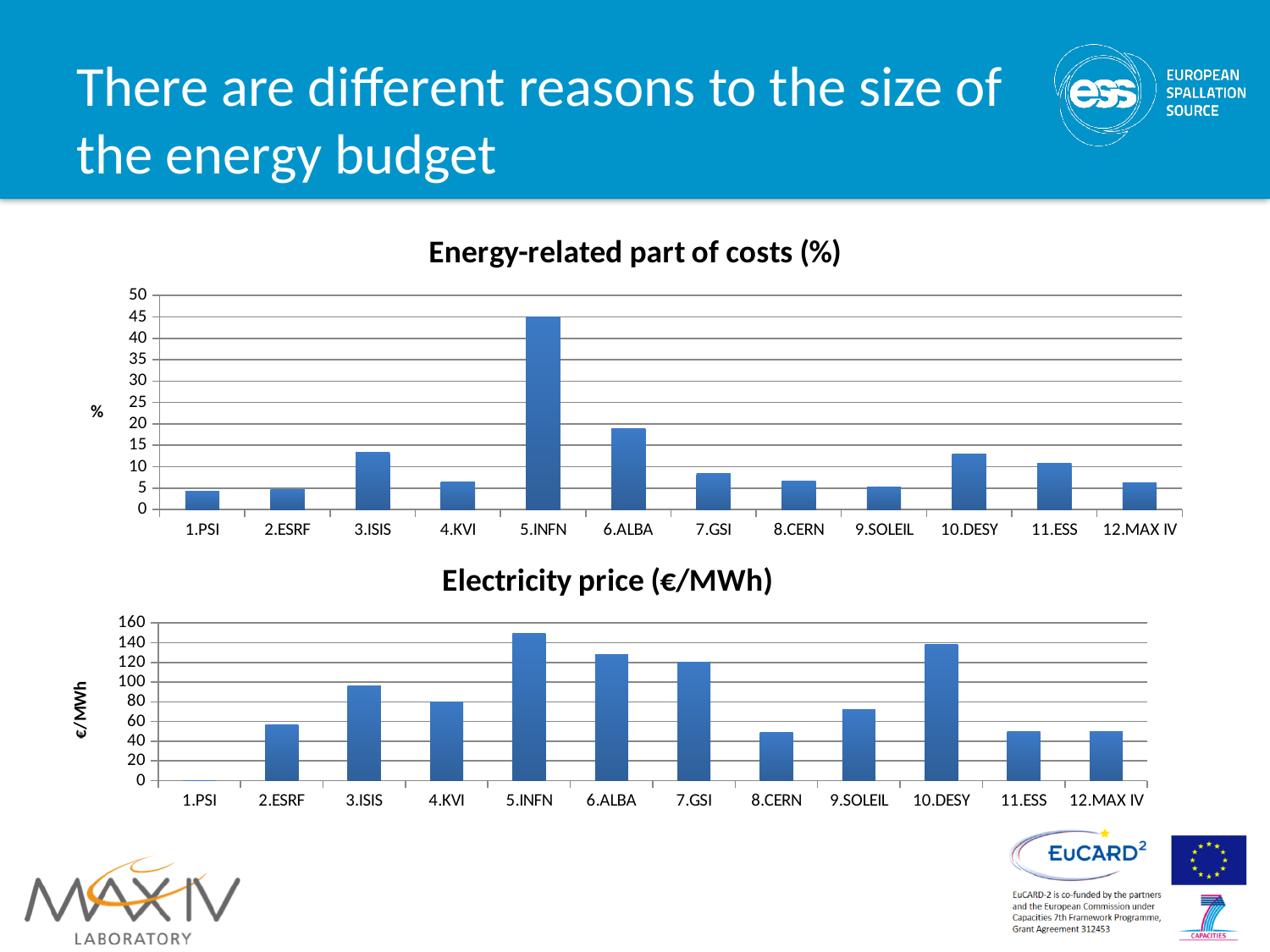
In the 'Electricity price (€/MWh)' chart, is the value for 10.DESY greater or less than 120? greater How many facilities are shown on the x axis of the 'Energy-related part of costs (%)' chart? 12 In the 'Energy-related part of costs (%)' chart, which facility has the highest value? 5.INFN In the 'Electricity price (€/MWh)' chart, which facility has the lowest electricity price? 1.PSI In the 'Energy-related part of costs (%)' chart, is the value for 5.INFN greater or less than 40? greater What type of chart is the 'Electricity price (€/MWh)' chart? bar chart What is the y-axis label of the 'Electricity price (€/MWh)' chart? €/MWh In the 'Energy-related part of costs (%)' chart, which is larger, the value for 3.ISIS or the value for 7.GSI? 3.ISIS In the 'Electricity price (€/MWh)' chart, which is larger, the value for 2.ESRF or the value for 4.KVI? 4.KVI In the 'Energy-related part of costs (%)' chart, is the value for 4.KVI greater or less than 10? less In the 'Electricity price (€/MWh)' chart, which facility has the highest electricity price? 5.INFN